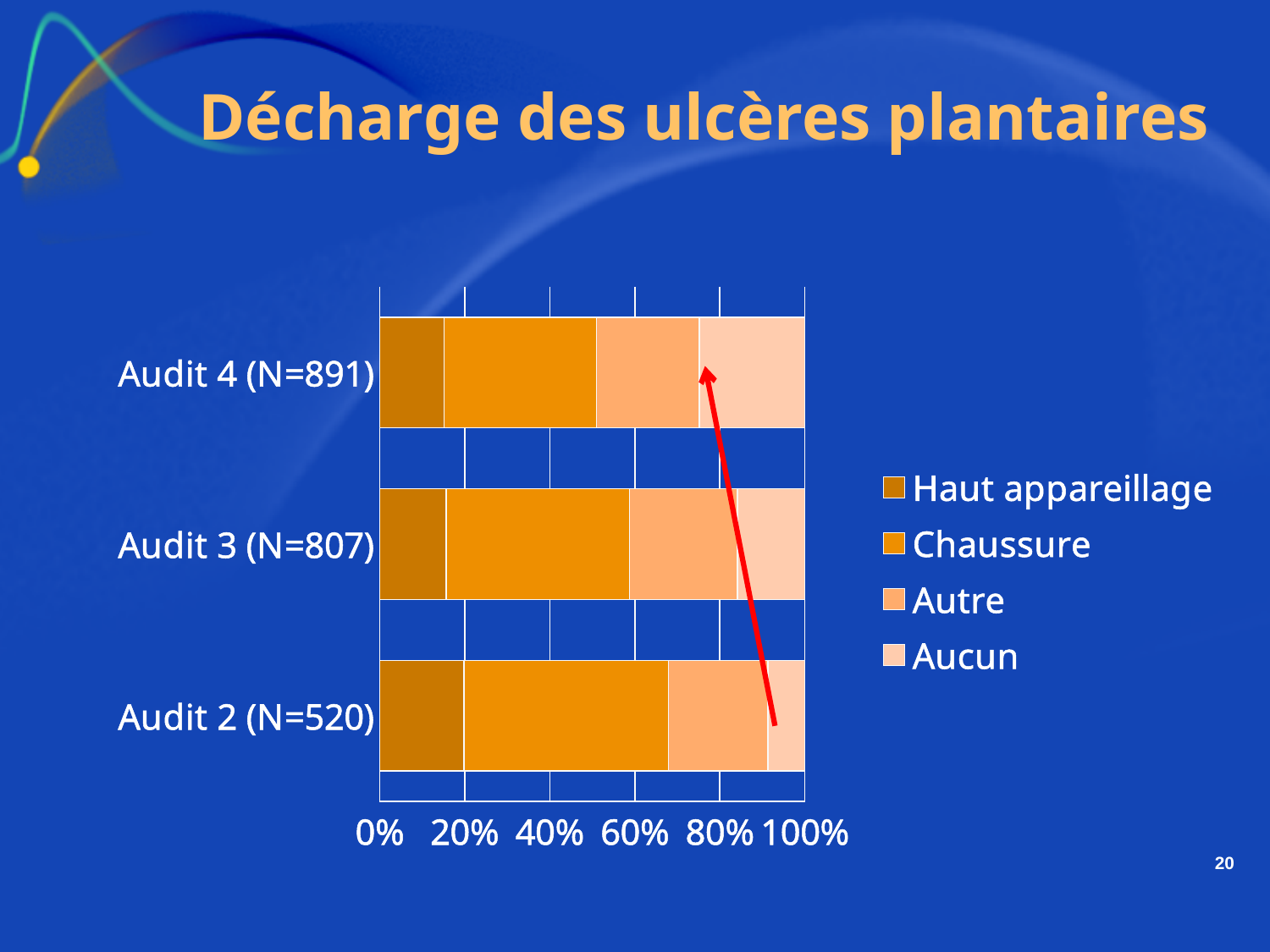
Which legend entry is shown in the lightest colour? Aucun Is the 'Chaussure' share for Audit 2 (N=520) greater or less than 40%? greater Is the 'Aucun' share for Audit 4 (N=891) greater or less than 20%? greater What is the title of the slide containing the chart? Décharge des ulcères plantaires Which is larger, the 'Chaussure' share for Audit 2 (N=520) or for Audit 4 (N=891)? Audit 2 (N=520) What kind of chart is shown on the slide? Stacked bar chart Is the 'Aucun' share for Audit 2 (N=520) greater or less than 20%? less Which audit has the largest 'Aucun' share? Audit 4 (N=891) Which audit has the smallest 'Aucun' share? Audit 2 (N=520) How many series does the legend list? 4 How many audits (categories) are plotted on the chart? 3 Does the 'Aucun' share rise or fall from Audit 2 to Audit 4? rise